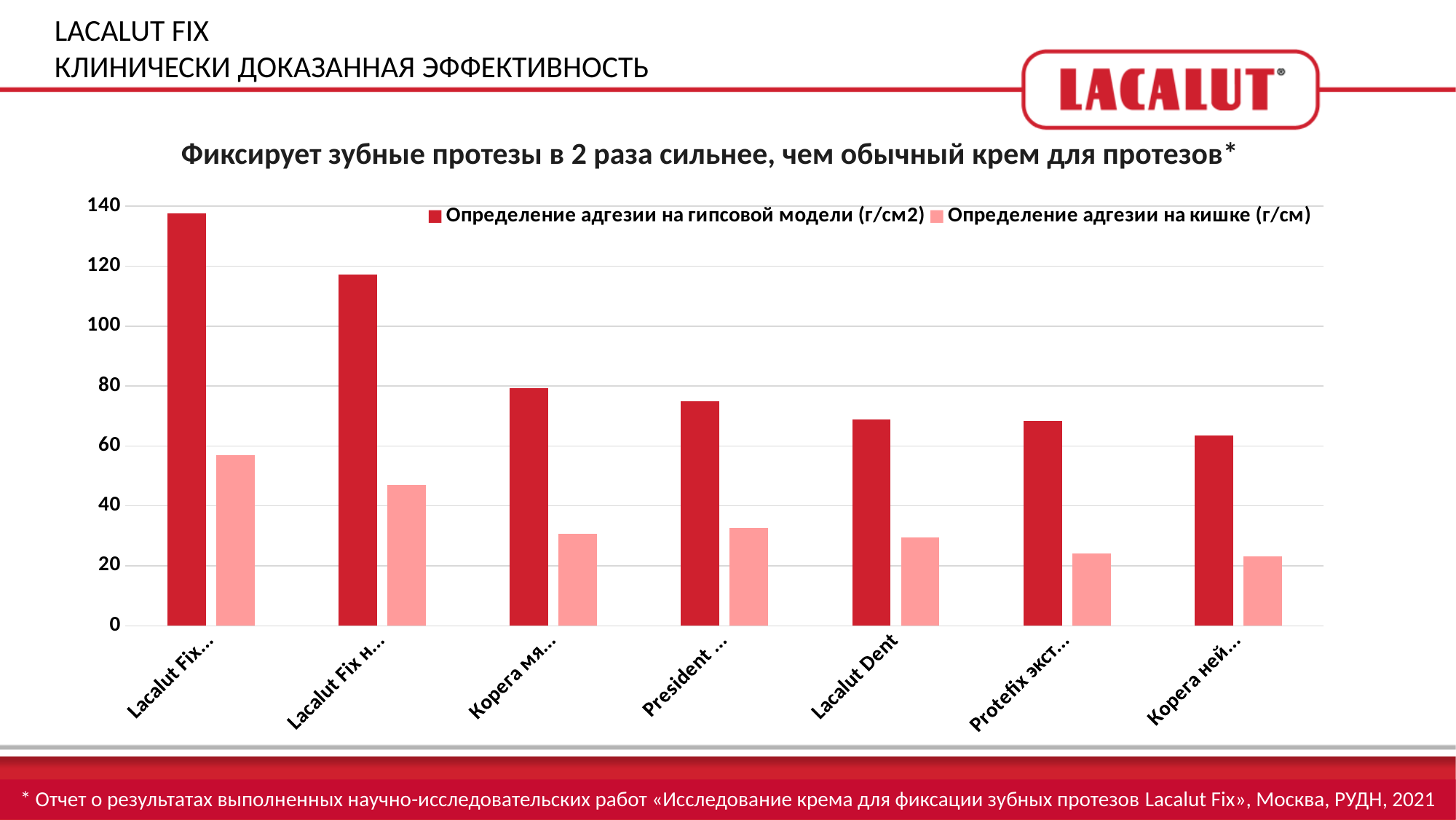
How many product categories are plotted along the x axis? 7 What colour are the bars of the series 'Определение адгезии на кишке (г/см)'? light pink Is the value for Lacalut Dent in the series 'Определение адгезии на гипсовой модели (г/см2)' greater or less than 60? greater Is the value of the leftmost category in the series 'Определение адгезии на гипсовой модели (г/см2)' greater or less than 120? greater What kind of chart is shown on the slide? bar chart For Lacalut Dent, which series has the larger value: 'Определение адгезии на гипсовой модели (г/см2)' or 'Определение адгезии на кишке (г/см)'? Определение адгезии на гипсовой модели (г/см2) Which is larger: the 'Определение адгезии на кишке (г/см)' value of the leftmost category or the 'Определение адгезии на гипсовой модели (г/см2)' value of Lacalut Dent? the 'Определение адгезии на гипсовой модели (г/см2)' value of Lacalut Dent What is the title of the chart? Фиксирует зубные протезы в 2 раза сильнее, чем обычный крем для протезов* Do the values of the series 'Определение адгезии на гипсовой модели (г/см2)' rise or fall from left to right along the x axis? fall How many series does the chart legend list? 2 Is the value for Lacalut Dent in the series 'Определение адгезии на кишке (г/см)' greater or less than 40? less Which category has the highest value for the series 'Определение адгезии на гипсовой модели (г/см2)'? the first (leftmost) category, Lacalut Fix…